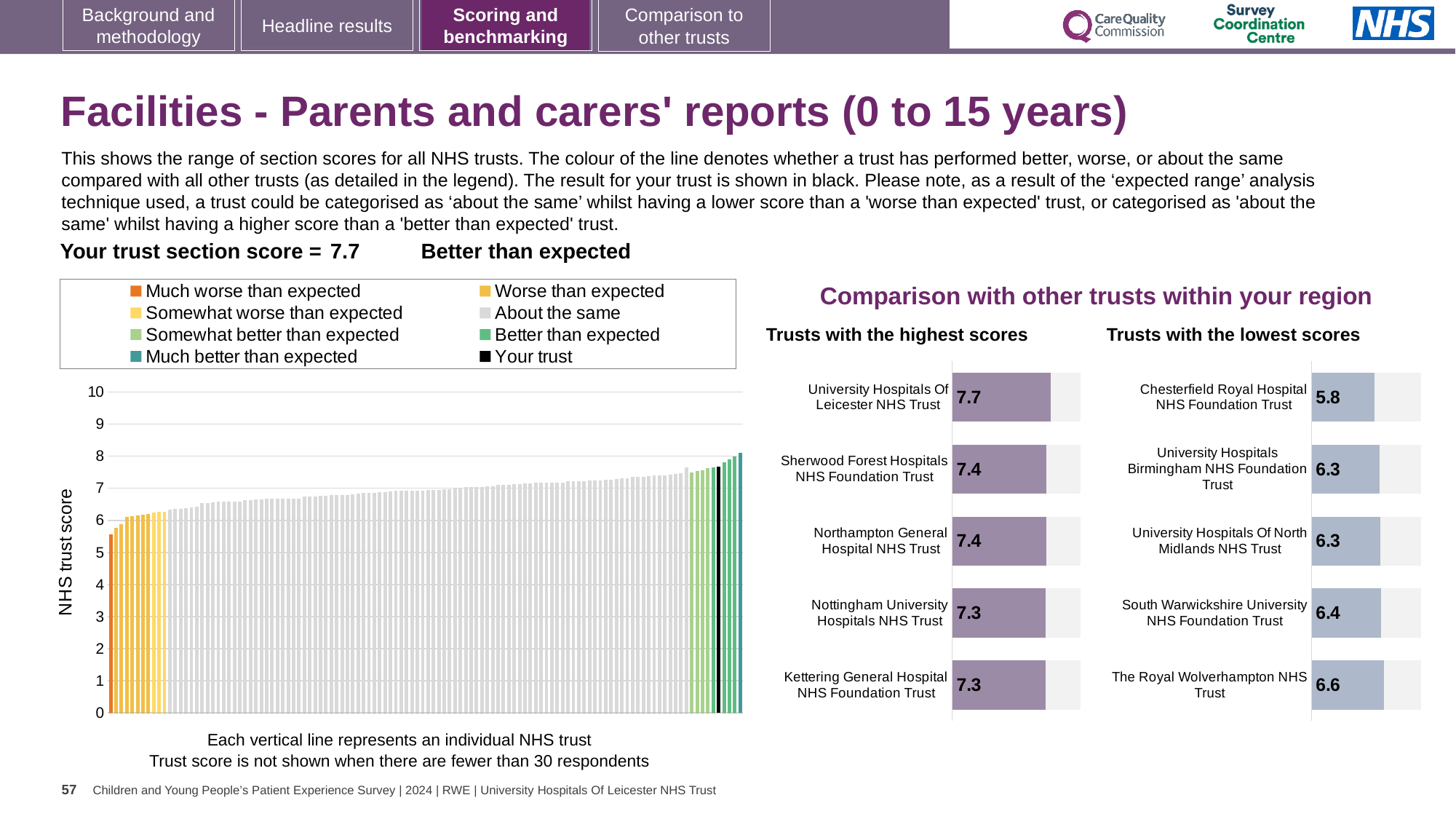
In the large chart on the left showing all NHS trusts, is the value of the lowest (leftmost) bar greater or less than 6? less What is the difference between the score for University Hospitals Of Leicester NHS Trust in the 'Trusts with the highest scores' chart and the score for Chesterfield Royal Hospital NHS Foundation Trust in the 'Trusts with the lowest scores' chart? 1.9 How many entries does the legend of the large chart on the left list? 8 In the 'Trusts with the lowest scores' chart, what is the difference between the scores for The Royal Wolverhampton NHS Trust and Chesterfield Royal Hospital NHS Foundation Trust? 0.8 In the 'Trusts with the highest scores' chart, which has the larger score: Sherwood Forest Hospitals NHS Foundation Trust or Nottingham University Hospitals NHS Trust? Sherwood Forest Hospitals NHS Foundation Trust In the 'Trusts with the highest scores' chart, what is the score for University Hospitals Of Leicester NHS Trust? 7.7 What kind of chart is the large chart on the left showing all NHS trusts? Bar chart In the 'Trusts with the highest scores' chart, what is the score for Kettering General Hospital NHS Foundation Trust? 7.3 In the 'Trusts with the lowest scores' chart, which trust has the highest score? The Royal Wolverhampton NHS Trust In the 'Trusts with the lowest scores' chart, what is the score for Chesterfield Royal Hospital NHS Foundation Trust? 5.8 In the 'Trusts with the lowest scores' chart, which trust has the lowest score? Chesterfield Royal Hospital NHS Foundation Trust How many trusts are listed in the 'Trusts with the lowest scores' chart? 5